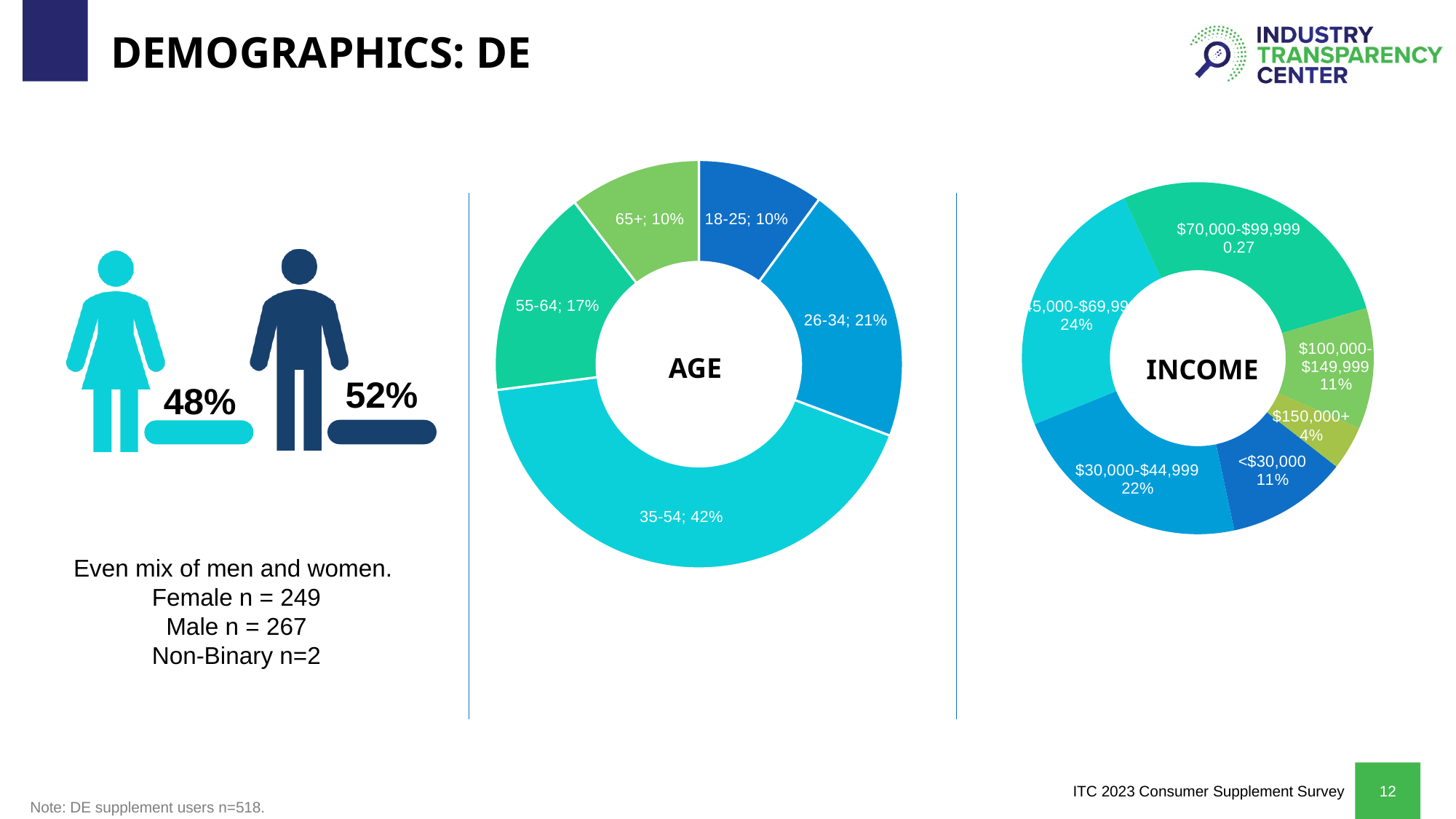
In the INCOME chart, which income group has the smallest share? $150,000+ In the AGE chart, what percentage of respondents are aged 35-54? 42% What type of chart is the AGE chart? Donut (pie) chart In the INCOME chart, what is the difference in percentage points between the $30,000-$44,999 group and the $150,000+ group? 18 percentage points In the INCOME chart, what value is printed for the $70,000-$99,999 group? 0.27 How many age groups are shown in the AGE chart? 5 In the AGE chart, what is the share for the 65+ age group? 10% In the AGE chart, what is the share for the 55-64 age group? 17% In the AGE chart, which age group has the largest share? 35-54 In the AGE chart, what is the difference in percentage points between the 26-34 and 55-64 groups? 4 percentage points In the INCOME chart, what is the share for the $30,000-$44,999 group? 22% How many income groups are shown in the INCOME chart? 6